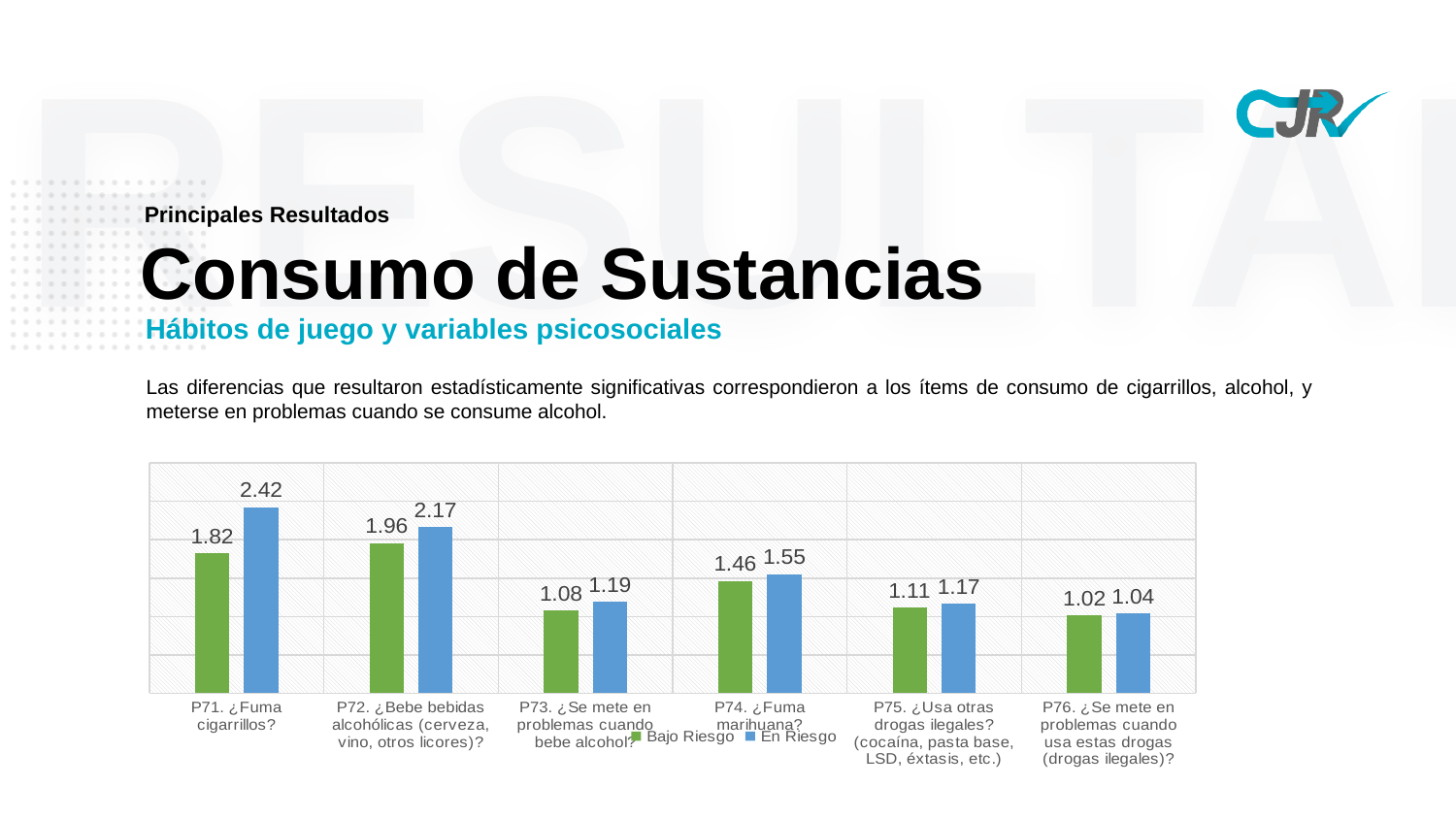
Which category has the highest En Riesgo value? P71. ¿Fuma cigarrillos? What kind of chart is shown on the slide? Bar chart Which category has the lowest Bajo Riesgo value? P76. ¿Se mete en problemas cuando usa estas drogas (drogas ilegales)? Which is larger for P72: the Bajo Riesgo value or the En Riesgo value? En Riesgo What is the difference between the En Riesgo and Bajo Riesgo values for P71. ¿Fuma cigarrillos? 0.60 What is the value for En Riesgo on P76. ¿Se mete en problemas cuando usa estas drogas (drogas ilegales)? 1.04 How many categories (questions) are shown on the x axis of the chart? 6 What is the value for Bajo Riesgo on P71. ¿Fuma cigarrillos? 1.82 What is the value for Bajo Riesgo on P74. ¿Fuma marihuana? 1.46 What is the value for En Riesgo on P71. ¿Fuma cigarrillos? 2.42 What is the value for En Riesgo on P72. ¿Bebe bebidas alcohólicas (cerveza, vino, otros licores)? 2.17 How many series does the legend list? 2